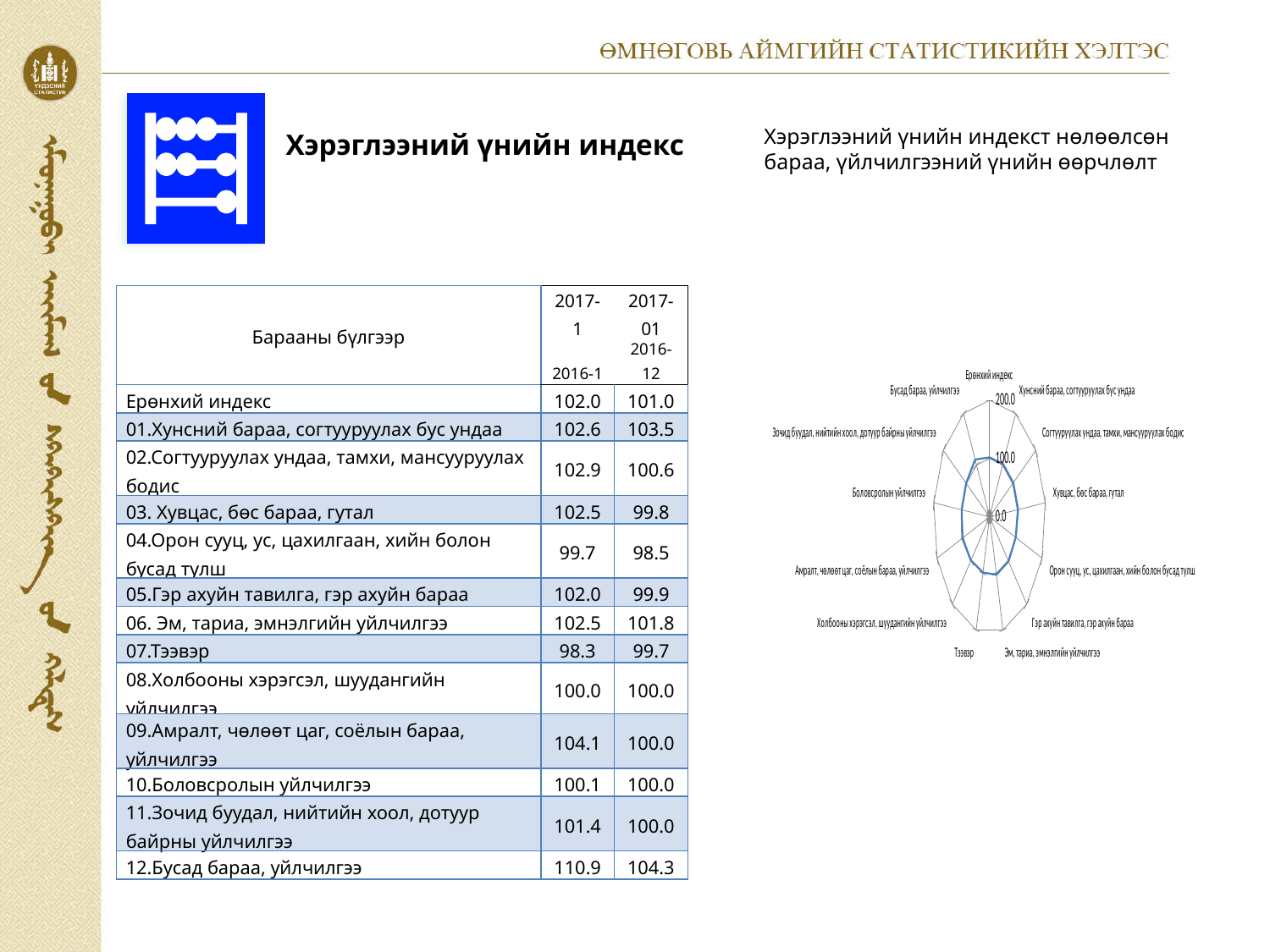
On the radar chart, is the value for Боловсролын үйлчилгээ greater or less than 200? less How many categories (axes) does the radar chart have? 13 On the radar chart, is the value for Бусад бараа, үйлчилгээ greater or less than 200? less On the radar chart, is the value for Тээвэр greater or less than 200? less Which category label appears at the top of the radar chart? Ерөнхий индекс What kind of chart is shown on the right side of the slide? radar chart What is the highest value shown on the radar chart's axis scale? 200.0 What is the value at the centre of the radar chart's axis scale? 0.0